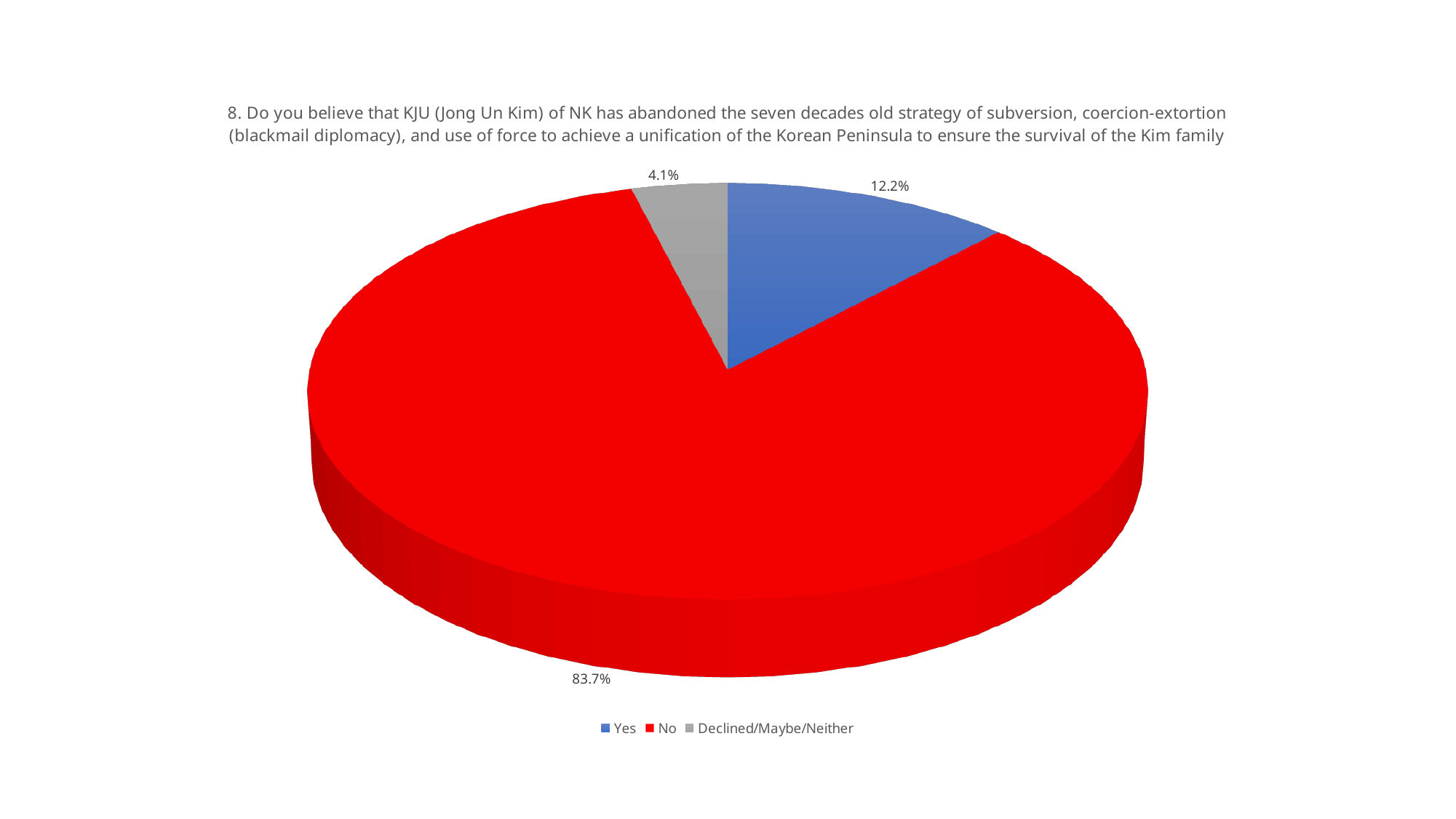
What is the difference in percentage points between the "Yes" and "Declined/Maybe/Neither" shares? 8.1 What is the difference in percentage points between the "No" and "Yes" shares? 71.5 What percentage of respondents are in the "Declined/Maybe/Neither" category? 4.1% What percentage of respondents answered "No"? 83.7% What colour is the "No" slice in the pie chart? Red How many categories does the pie chart show? 3 What kind of chart is shown on the slide? Pie chart Which response category has the smallest share of the pie? Declined/Maybe/Neither What is the third entry listed in the legend? Declined/Maybe/Neither What percentage of respondents answered "Yes"? 12.2% Which is larger, the share for "Yes" or the share for "Declined/Maybe/Neither"? Yes Which response category has the largest share of the pie? No